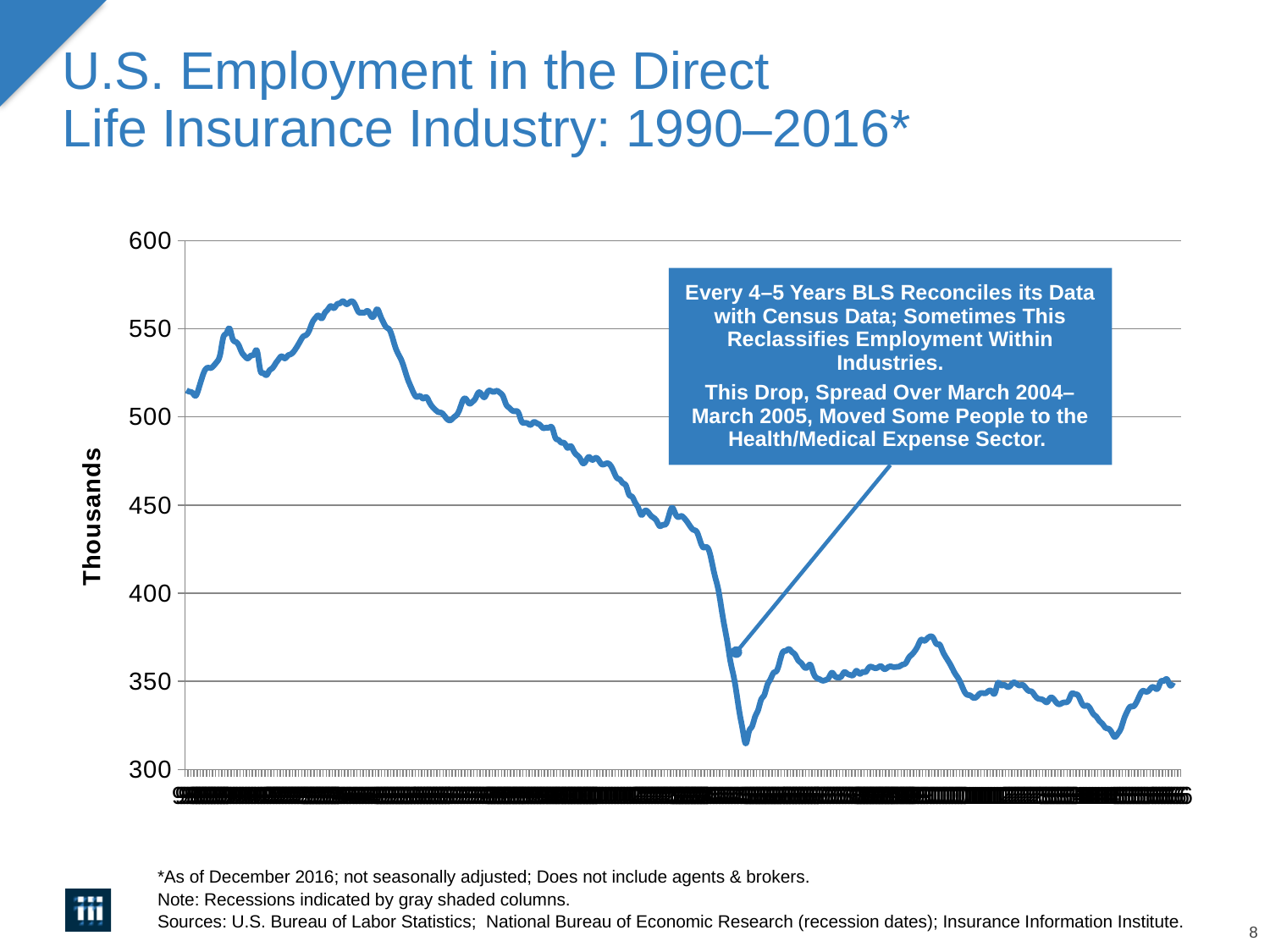
Is the value at the start of the series (1990) greater or less than 500? greater Is the lowest point on the line greater or less than 350? less What kind of chart is shown on the slide? line chart Overall, do the values rise or fall from the start of the series to the end? fall Which is larger, the value at the start of the series or the value at the end of the series? the value at the start Is the highest point on the line greater or less than 550? greater What is the title of the vertical axis? Thousands What is the highest value shown on the vertical axis? 600